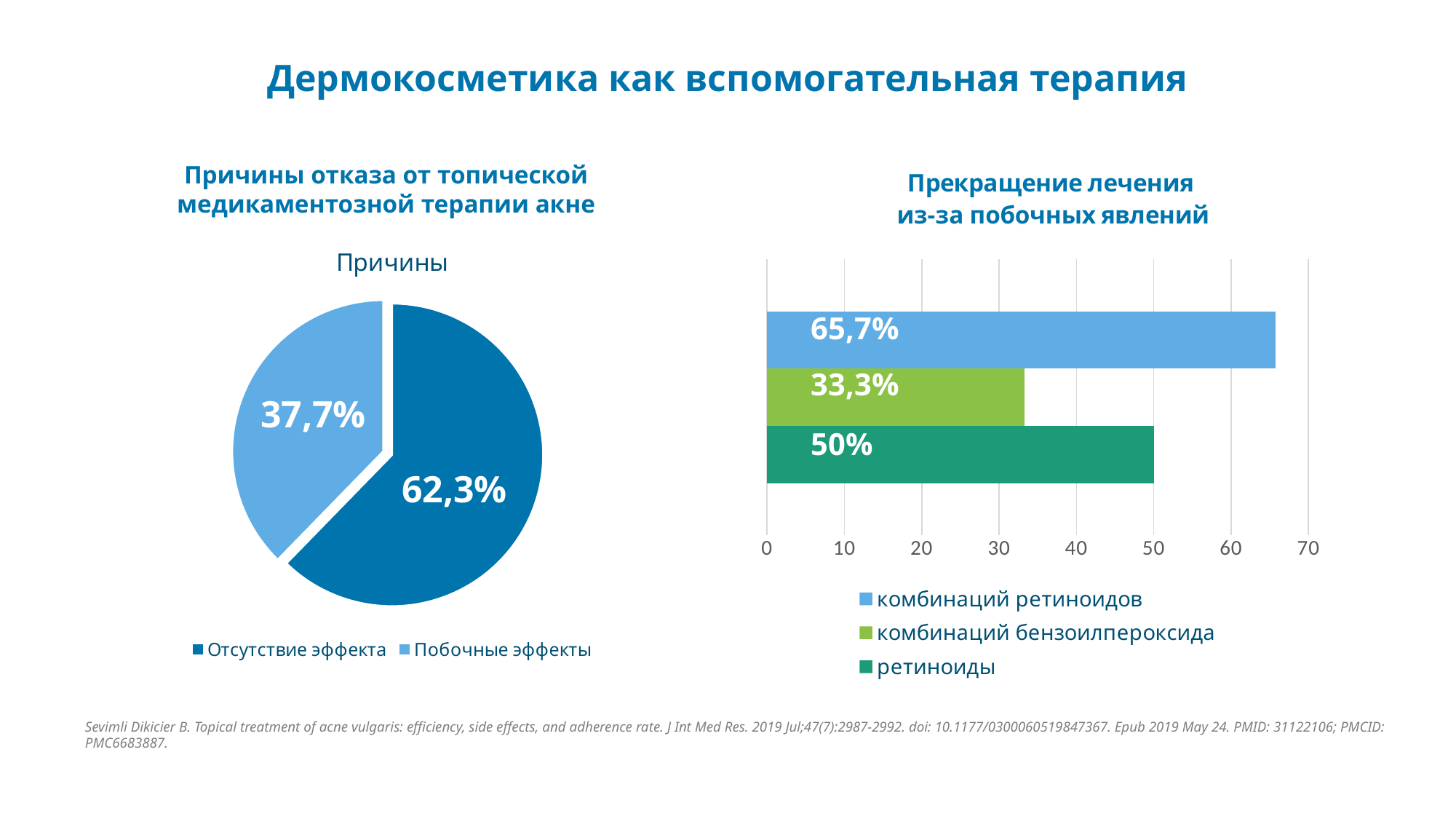
In the bar chart 'Прекращение лечения из-за побочных явлений' on the right, what is the difference between 'комбинаций ретиноидов' and 'комбинаций бензоилпероксида'? 32,4% In the pie chart 'Причины' on the left, which slice is larger: 'Отсутствие эффекта' or 'Побочные эффекты'? Отсутствие эффекта In the bar chart 'Прекращение лечения из-за побочных явлений' on the right, which series has the lowest value? комбинаций бензоилпероксида In the pie chart 'Причины' on the left, how many slices are there? 2 In the bar chart 'Прекращение лечения из-за побочных явлений' on the right, what is the value for 'ретиноиды'? 50% In the pie chart 'Причины' on the left, what is the difference between the 'Отсутствие эффекта' and 'Побочные эффекты' slices? 24,6% In the pie chart 'Причины' on the left, what share is labelled for 'Побочные эффекты'? 37,7% In the bar chart 'Прекращение лечения из-за побочных явлений' on the right, which series has the highest value? комбинаций ретиноидов What type of chart is the left chart titled 'Причины'? Pie chart In the pie chart 'Причины' on the left, what share is labelled for 'Отсутствие эффекта'? 62,3% How many series does the legend of the bar chart 'Прекращение лечения из-за побочных явлений' on the right list? 3 In the bar chart 'Прекращение лечения из-за побочных явлений' on the right, what is the value for 'комбинаций ретиноидов'? 65,7%